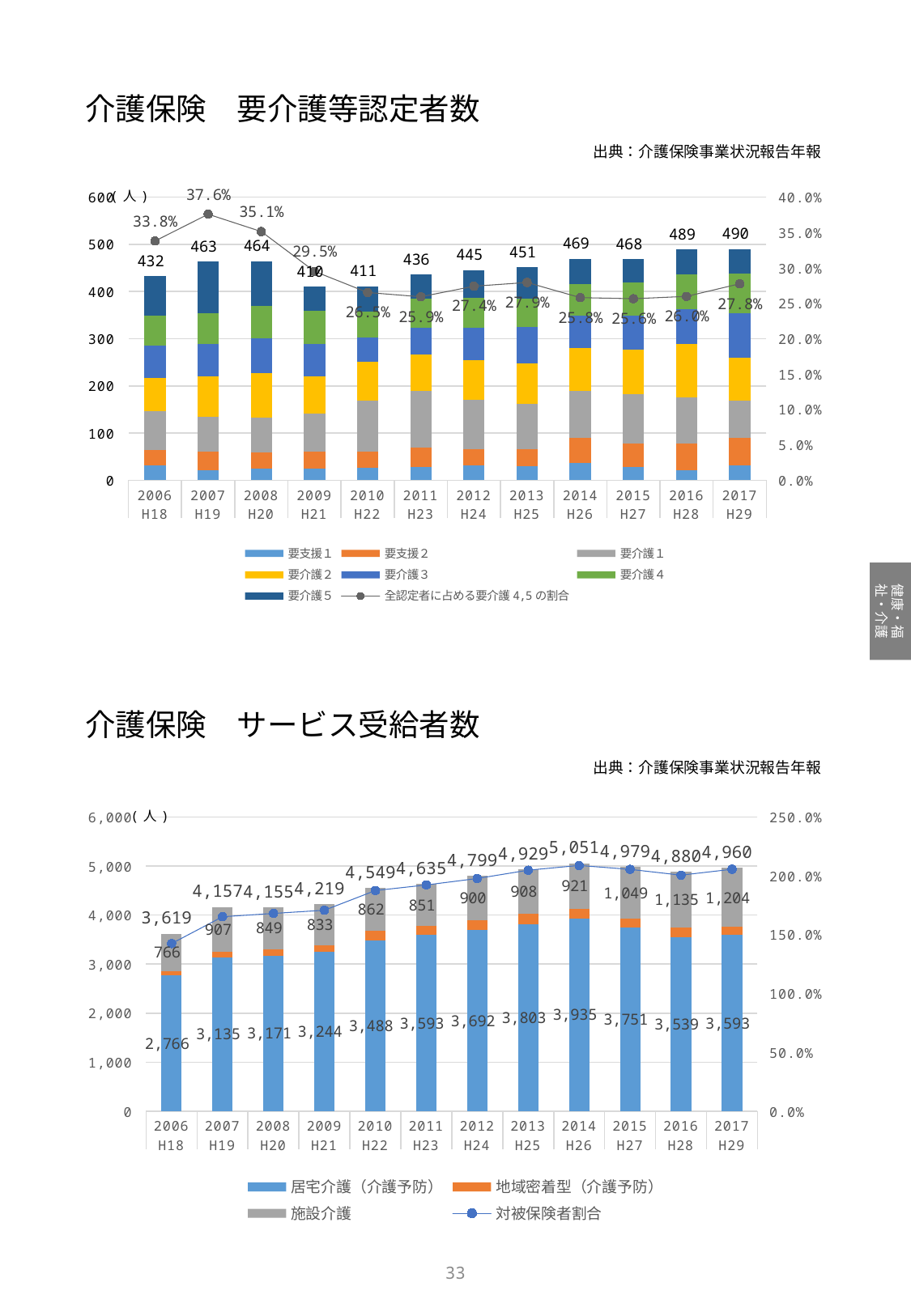
In the top chart (介護保険 要介護等認定者数), what is the 全認定者に占める要介護4,5の割合 value for 2007 (H19)? 37.6% In the top chart (介護保険 要介護等認定者数), how many series does the legend list? 8 In the bottom chart (介護保険 サービス受給者数), what is the total number of service recipients in 2014 (H26)? 5,051 What kind of chart is the bottom chart (介護保険 サービス受給者数)? Stacked bar chart with a line In the top chart (介護保険 要介護等認定者数), what is the total number of certified persons in 2017 (H29)? 490 In the top chart (介護保険 要介護等認定者数), which year has the lowest total number of certified persons? 2009 (H21) In the bottom chart (介護保険 サービス受給者数), what is the 施設介護 value for 2017 (H29)? 1,204 In the bottom chart (介護保険 サービス受給者数), is the 居宅介護（介護予防） value for 2006 (H18) larger or smaller than the value for 2007 (H19)? smaller In the top chart (介護保険 要介護等認定者数), which year has the highest 全認定者に占める要介護4,5の割合 value? 2007 (H19) In the bottom chart (介護保険 サービス受給者数), which year has the highest 居宅介護（介護予防） value? 2014 (H26) In the top chart (介護保険 要介護等認定者数), what is the difference between the total for 2016 (H28) and the total for 2006 (H18)? 57 In the bottom chart (介護保険 サービス受給者数), how many years are shown on the x axis? 12